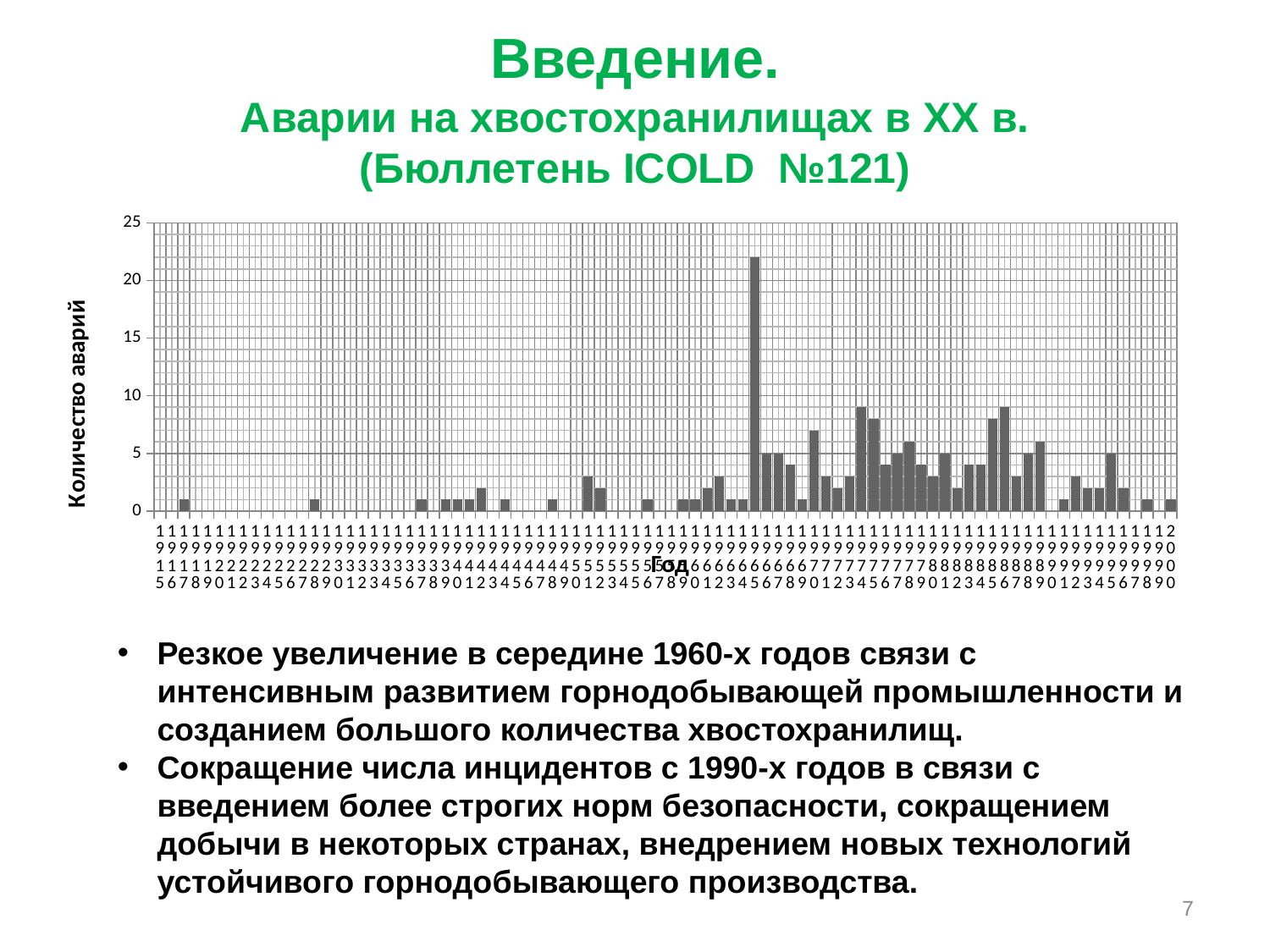
Is the value of the tallest bar in the chart greater or less than 25? less What is the title of the vertical axis of the chart? Количество аварий Is the value of the tallest bar in the chart greater or less than 20? greater What kind of chart is shown on the slide? bar chart Is any bar for a year before 1960 greater or less than 5? less In which decade does the tallest bar of the chart fall? 1960s Are the bars for the years before 1960 generally higher or lower than the bars for the years after 1960? lower What is the title of the horizontal axis of the chart? Год What is the highest tick value shown on the vertical axis? 25 Do the bar values generally rise or fall from the 1980s to the late 1990s? fall